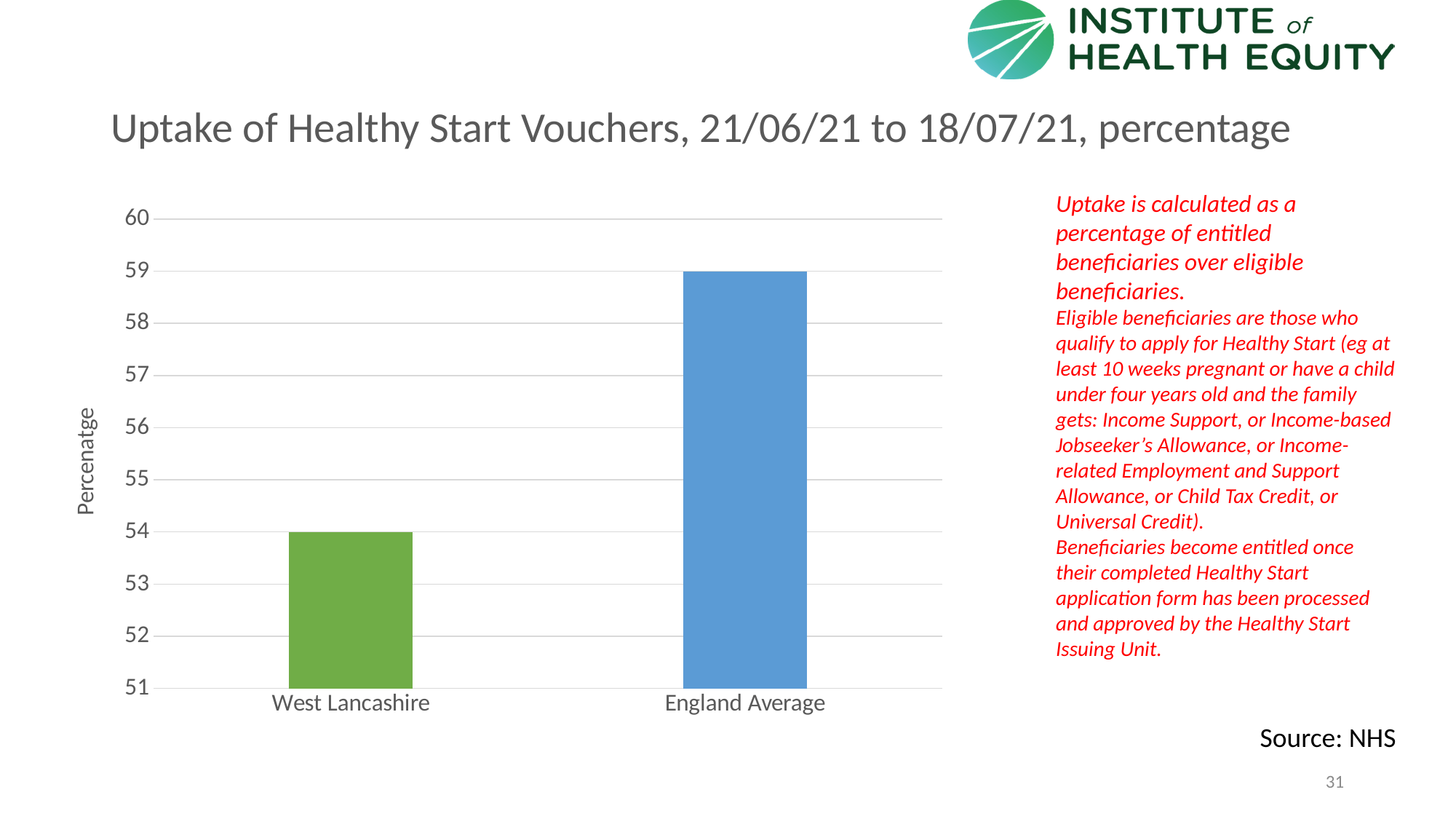
What is the uptake percentage for the England Average? 59 Which category has the lowest uptake? West Lancashire What is the difference between the England Average and West Lancashire uptake values? 5 What is the uptake percentage for West Lancashire? 54 What type of chart is shown on the slide? bar chart Is the value for West Lancashire greater or less than 55? less How many categories are plotted in the chart? 2 What colour is the bar for West Lancashire? green Is the value for England Average greater or less than 58? greater What is the label on the vertical axis of the chart? Percenatge Which is larger, the value for West Lancashire or the value for England Average? England Average Which category has the highest uptake? England Average